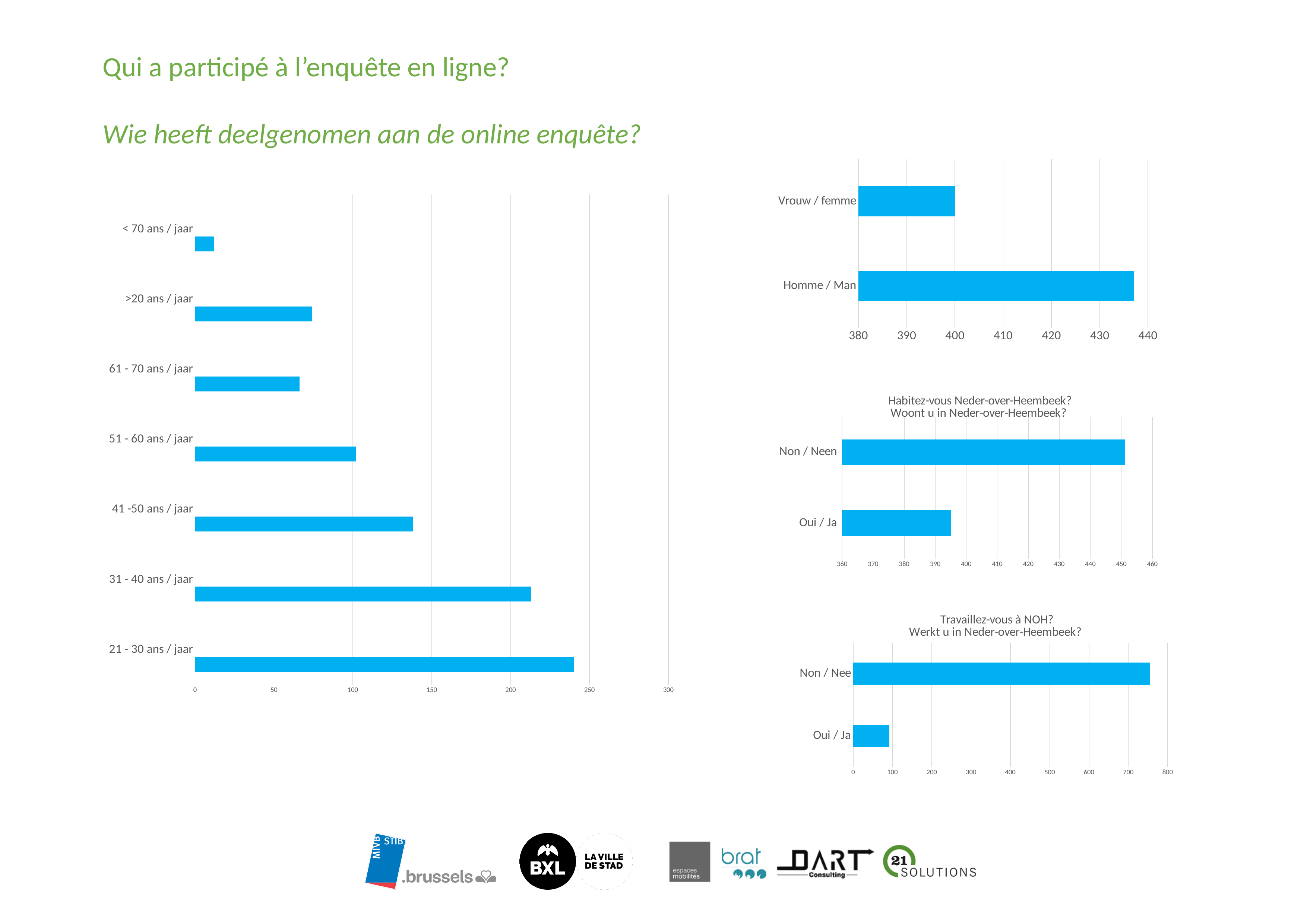
On the age chart on the left of the slide, is the value for 31 - 40 ans / jaar greater or less than 200? greater On the age chart on the left of the slide, which is larger, the value for 51 - 60 ans / jaar or the value for 61 - 70 ans / jaar? 51 - 60 ans / jaar On the chart titled 'Travaillez-vous à NOH?', is the value for Non / Nee greater or less than 700? greater On the chart titled 'Habitez-vous Neder-over-Heembeek?', which category has the higher value? Non / Neen On the gender chart at the top right of the slide, which category has the higher value? Homme / Man On the age chart on the left of the slide, how many categories are shown? 7 On the gender chart at the top right of the slide, is the value for Homme / Man greater or less than 430? greater What kind of chart is the age chart on the left of the slide? bar chart On the age chart on the left of the slide, which age group has the highest value? 21 - 30 ans / jaar On the age chart on the left of the slide, which category has the lowest value? < 70 ans / jaar